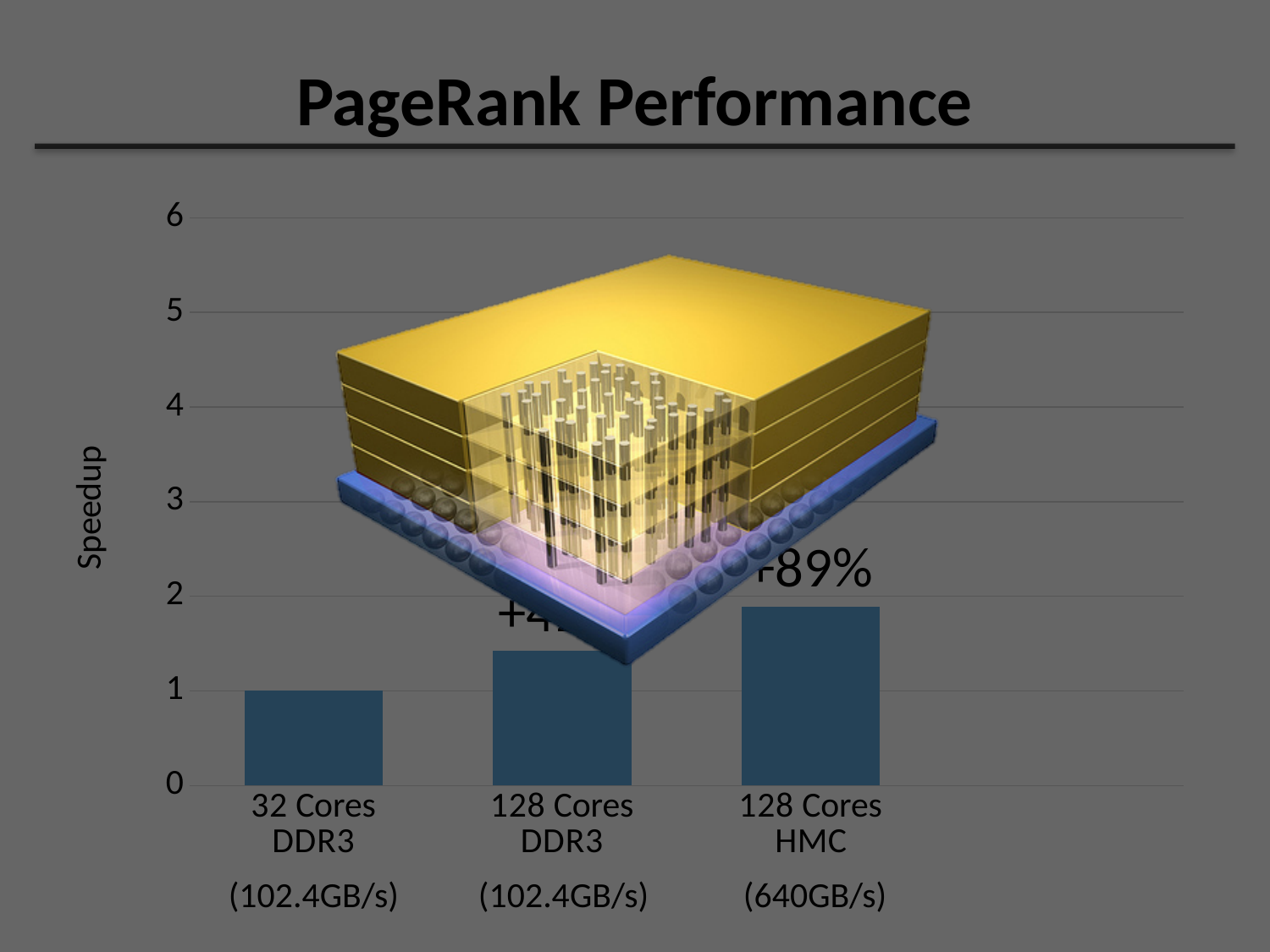
Is the speedup for 128 Cores DDR3 greater or less than 1? greater Which has a larger speedup, 128 Cores DDR3 or 128 Cores HMC? 128 Cores HMC What is the label on the vertical axis? Speedup Is the speedup for 128 Cores HMC greater or less than 2? less Is the speedup for 128 Cores HMC greater or less than 1? greater Which configuration has the lowest speedup? 32 Cores DDR3 How many bars are plotted in the chart? 3 What kind of chart is shown on the slide? bar chart What is the speedup value for 32 Cores DDR3? 1 What is the title of the chart? PageRank Performance Do the speedup values rise or fall from left to right across the bars? rise Which configuration has the highest speedup? 128 Cores HMC